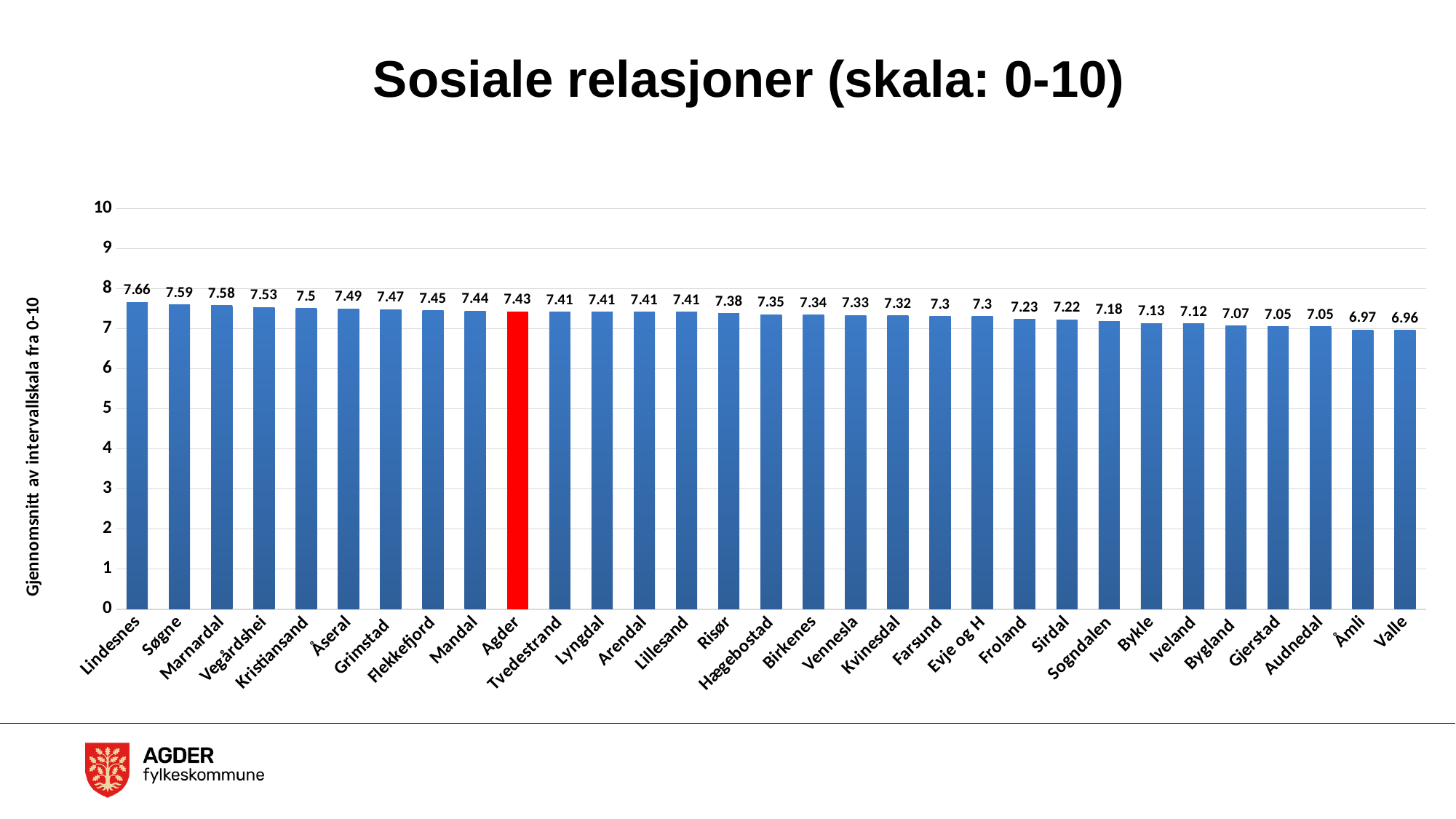
Which category has the lowest value? Valle What is the value for Valle? 6.96 What is the difference between the values for Agder and Arendal? 0.02 Which is larger, the value for Søgne or the value for Bykle? Søgne What is the value for Kristiansand? 7.5 What is the difference between the values for Lindesnes and Valle? 0.7 Which bar is coloured red instead of blue? Agder What kind of chart is shown on the slide? bar chart What is the value for Agder? 7.43 How many categories are shown on the x axis? 31 Is the value for Åmli greater or less than 7? less Which category has the highest value? Lindesnes